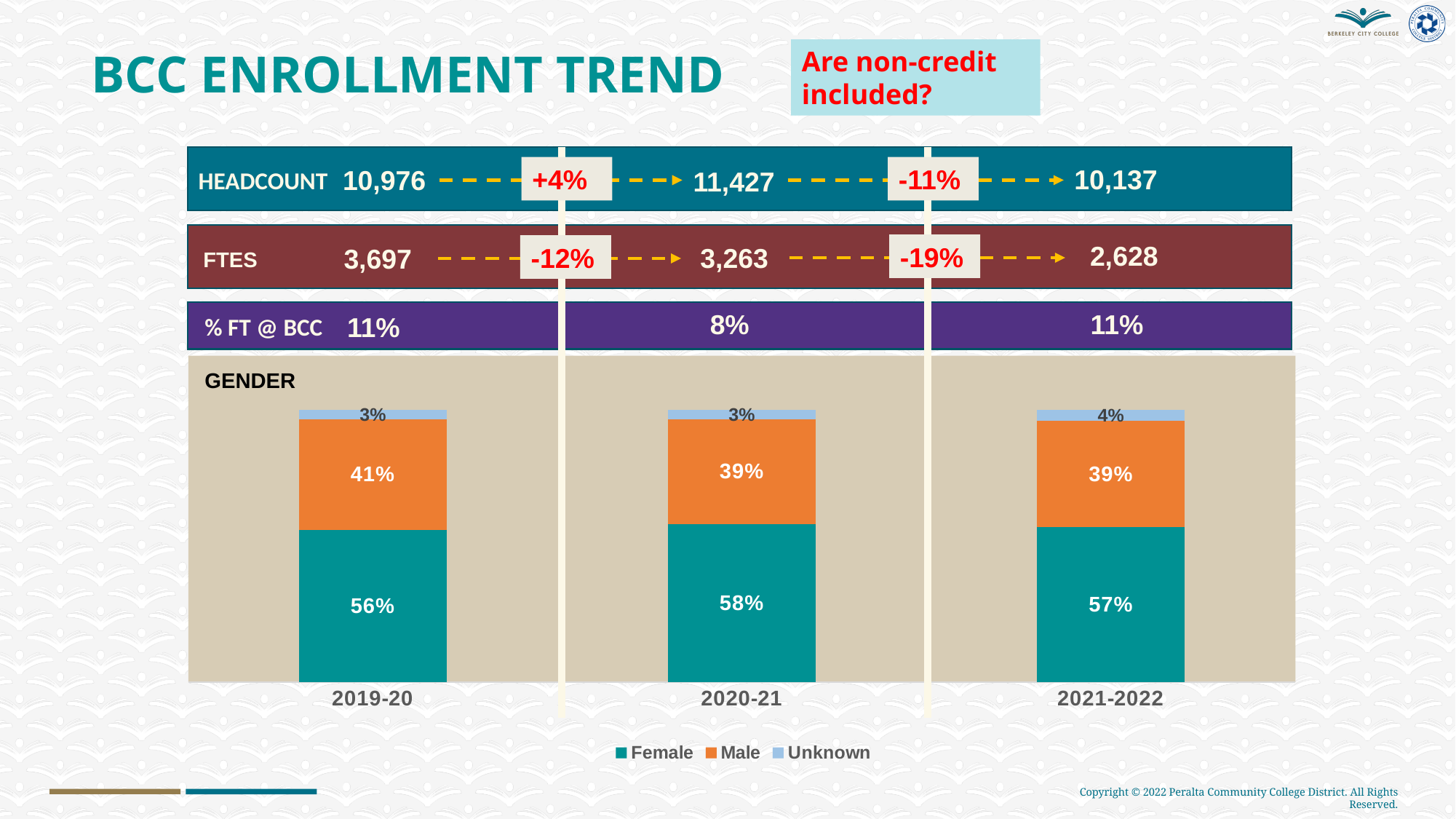
In the GENDER chart, what is the Female share for 2020-21? 58% In the GENDER chart, what is the difference between the Male share in 2019-20 and in 2020-21? 2% In the GENDER chart, which colour represents Male? Orange How many years are shown on the x axis of the GENDER chart? 3 In the GENDER chart, which year has the highest Female share? 2020-21 In the GENDER chart, what is the total of the stacked bar for 2019-20? 100% How many series does the legend of the GENDER chart list? 3 In the GENDER chart, what is the Unknown share for 2021-2022? 4% In the GENDER chart, which year has the lowest Female share? 2019-20 In the GENDER chart, is the Female share larger in 2019-20 or in 2021-2022? 2021-2022 In the GENDER chart, what is the Male share for 2019-20? 41% What kind of chart is the GENDER chart? Stacked bar chart